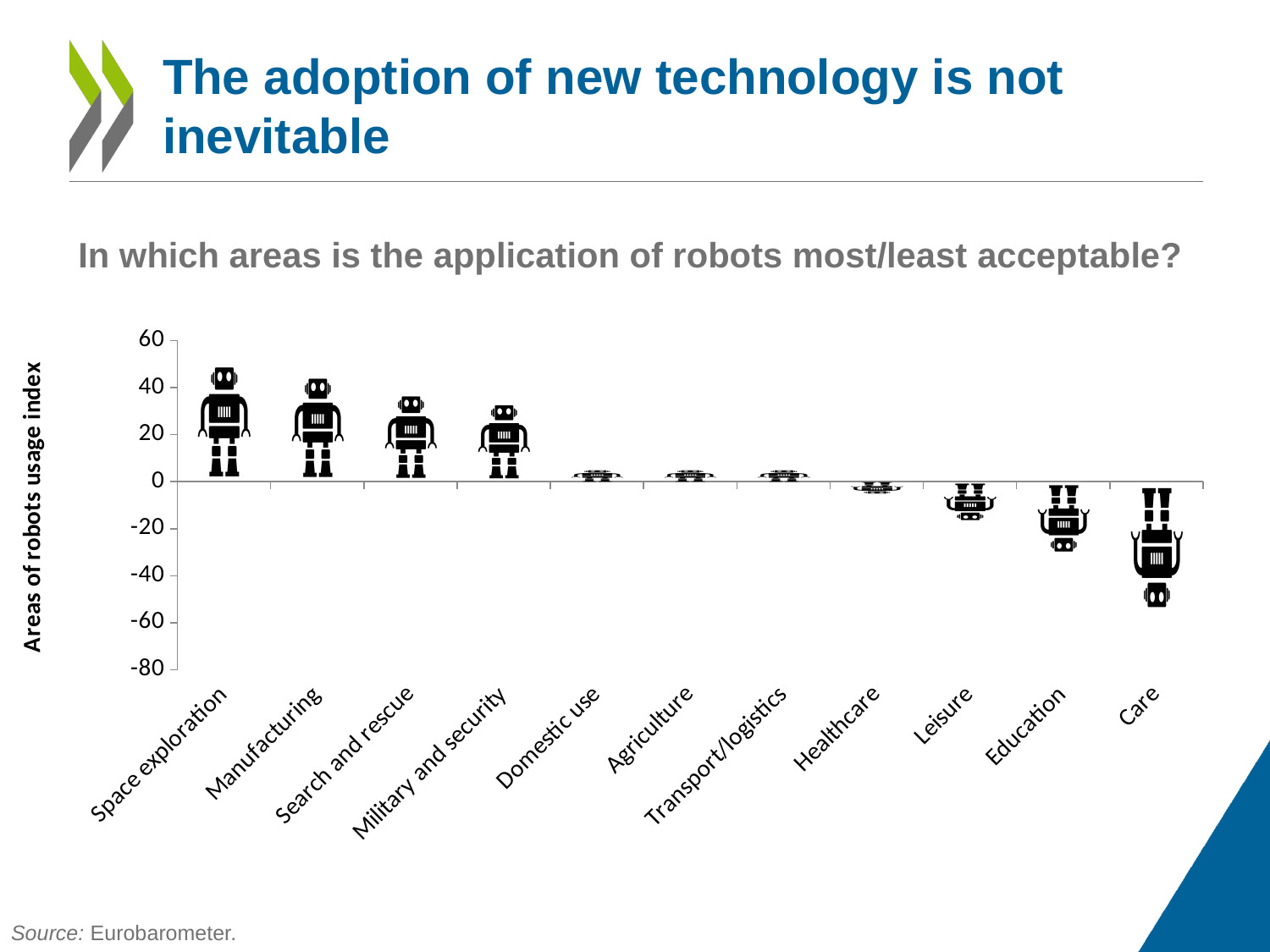
Is the value for Education greater or less than -20? less How many areas are shown on the x axis of the chart? 11 Is the value for Space exploration greater or less than 20? greater Which area has the lowest robots usage index value? Care Which has a higher value, Manufacturing or Education? Manufacturing Which area has the highest robots usage index value? Space exploration Is the value for Manufacturing greater or less than 20? greater What source is cited for the chart? Eurobarometer What is the label of the vertical axis? Areas of robots usage index Do the values rise or fall moving from left to right along the x axis? fall